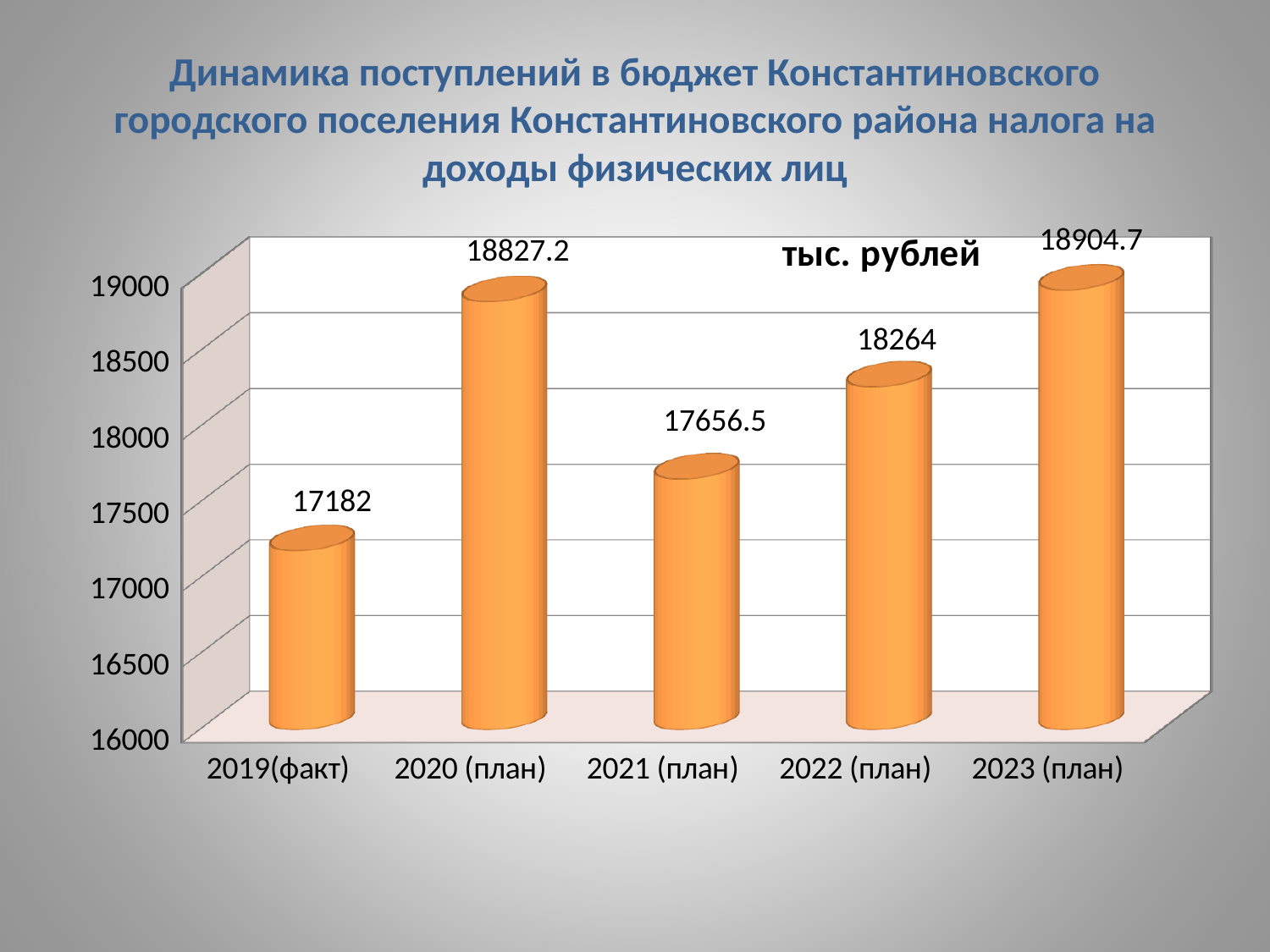
How many categories are shown on the x axis? 5 What is the difference between the values for 2023 (план) and 2019(факт)? 1722.7 What is the value for 2021 (план)? 17656.5 Is the value for 2021 (план) greater or less than 18000? less Which category has the lowest value? 2019(факт) Which category has the highest value? 2023 (план) What is the value for 2023 (план)? 18904.7 What is the value for 2019(факт)? 17182 What unit of measurement is indicated on the chart? тыс. рублей What kind of chart is shown on the slide? bar chart Which is larger, the value for 2020 (план) or the value for 2022 (план)? 2020 (план) What is the difference between the values for 2022 (план) and 2021 (план)? 607.5